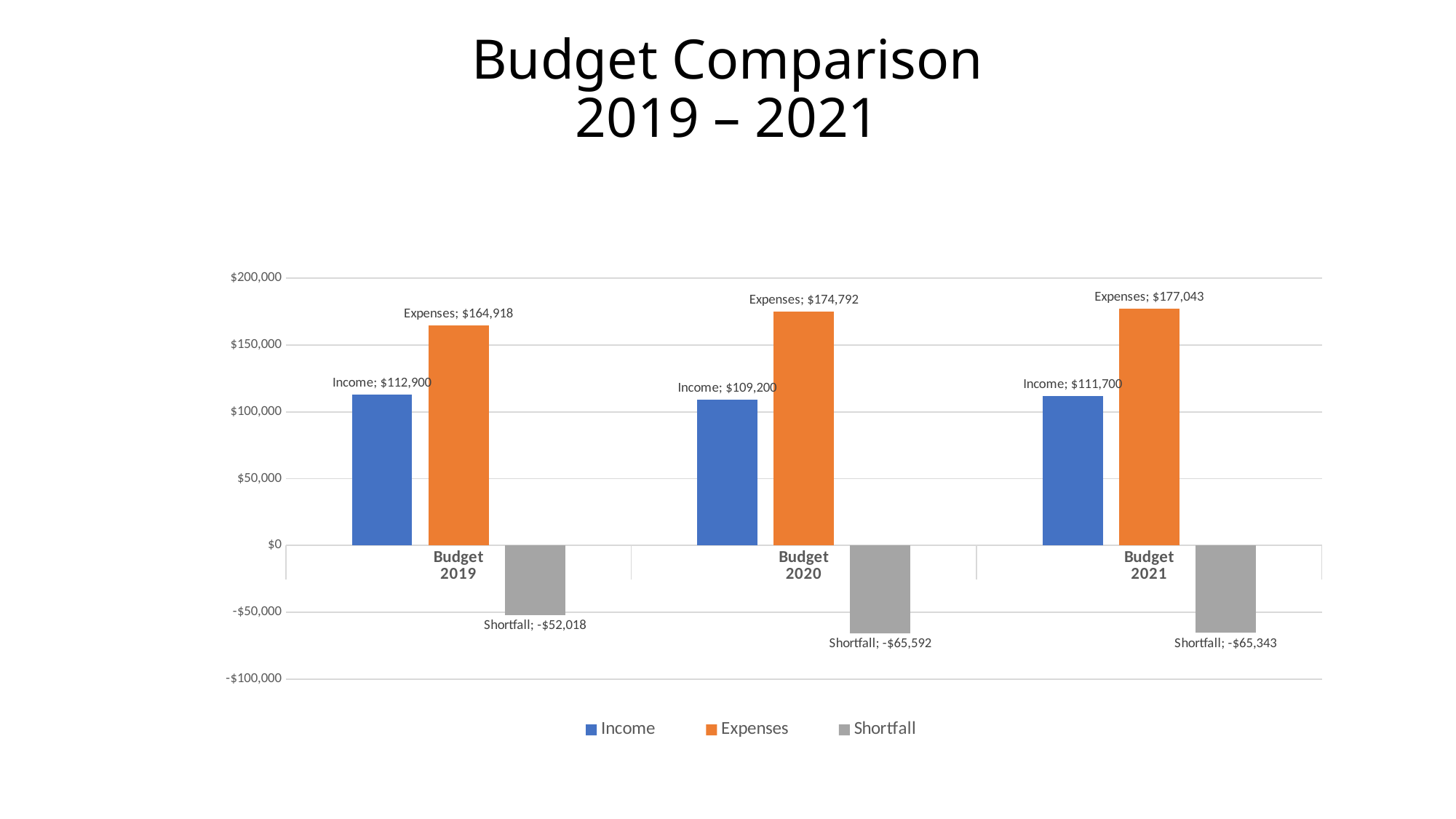
What is the difference between Expenses and Income for Budget 2020? $65,592 Which is larger, the Income for Budget 2019 or the Income for Budget 2021? Income for Budget 2019 What colour are the Shortfall bars? grey Which budget year has the lowest Income? Budget 2020 Is the Expenses value for Budget 2019 greater or less than $150,000? greater What kind of chart is shown on the slide? bar chart What is the Shortfall value for Budget 2020? -$65,592 What is the Income value for Budget 2019? $112,900 How many budget years are shown on the x axis? 3 What is the Expenses value for Budget 2021? $177,043 How many series does the legend list? 3 Which budget year has the highest Expenses? Budget 2021